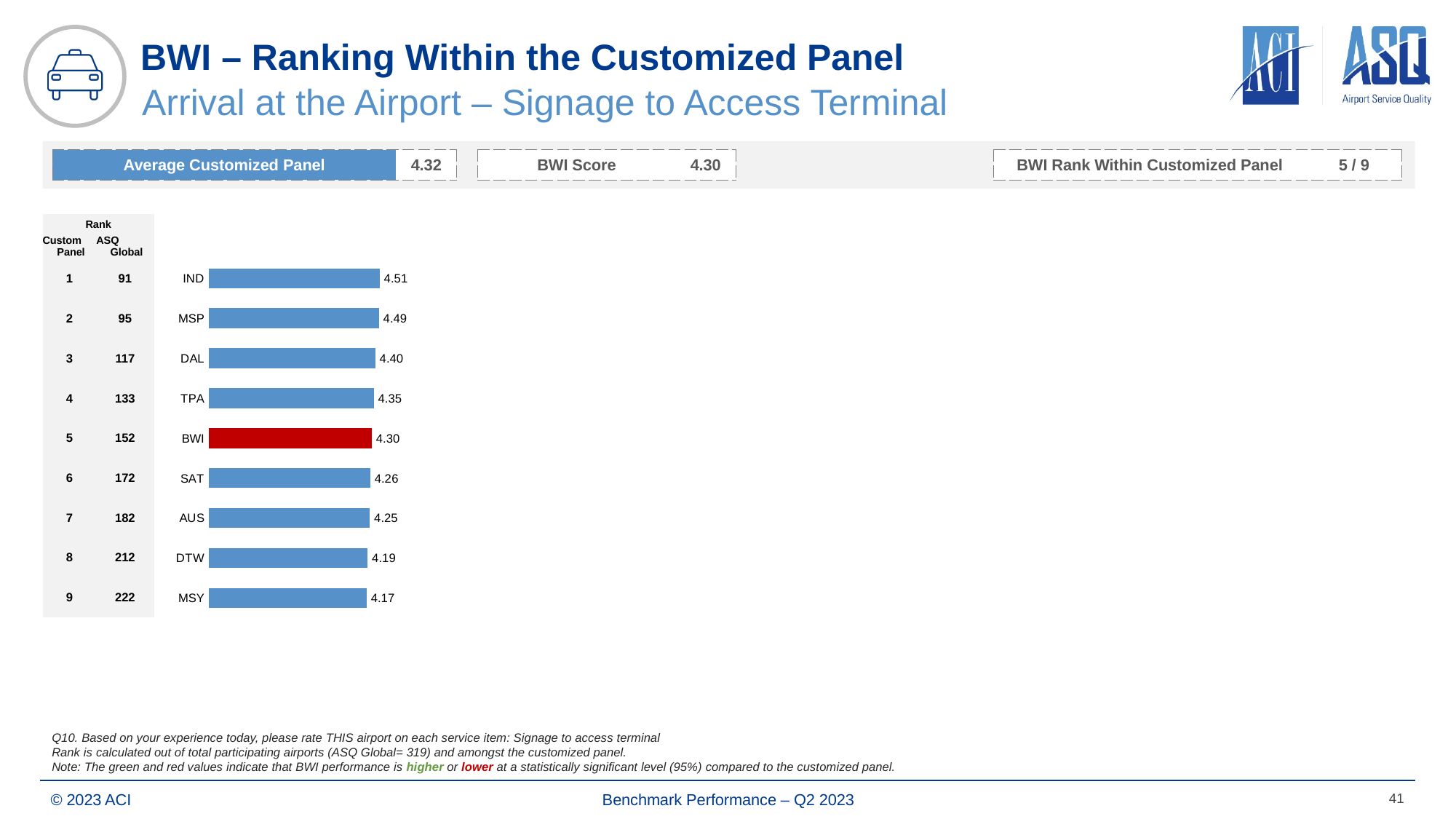
Do the scores rise or fall going down the chart from IND to MSY? Fall What is the score for IND? 4.51 Which airport has the lowest score? MSY What kind of chart is shown? Bar chart What is the difference between the scores for IND and MSY? 0.34 What is the difference between the scores for TPA and BWI? 0.05 How many airports are shown in the chart? 9 What is the score for BWI? 4.30 Which has a higher score, DAL or SAT? DAL Which airport's bar is coloured red? BWI Which airport has the highest score? IND What is the score for DTW? 4.19